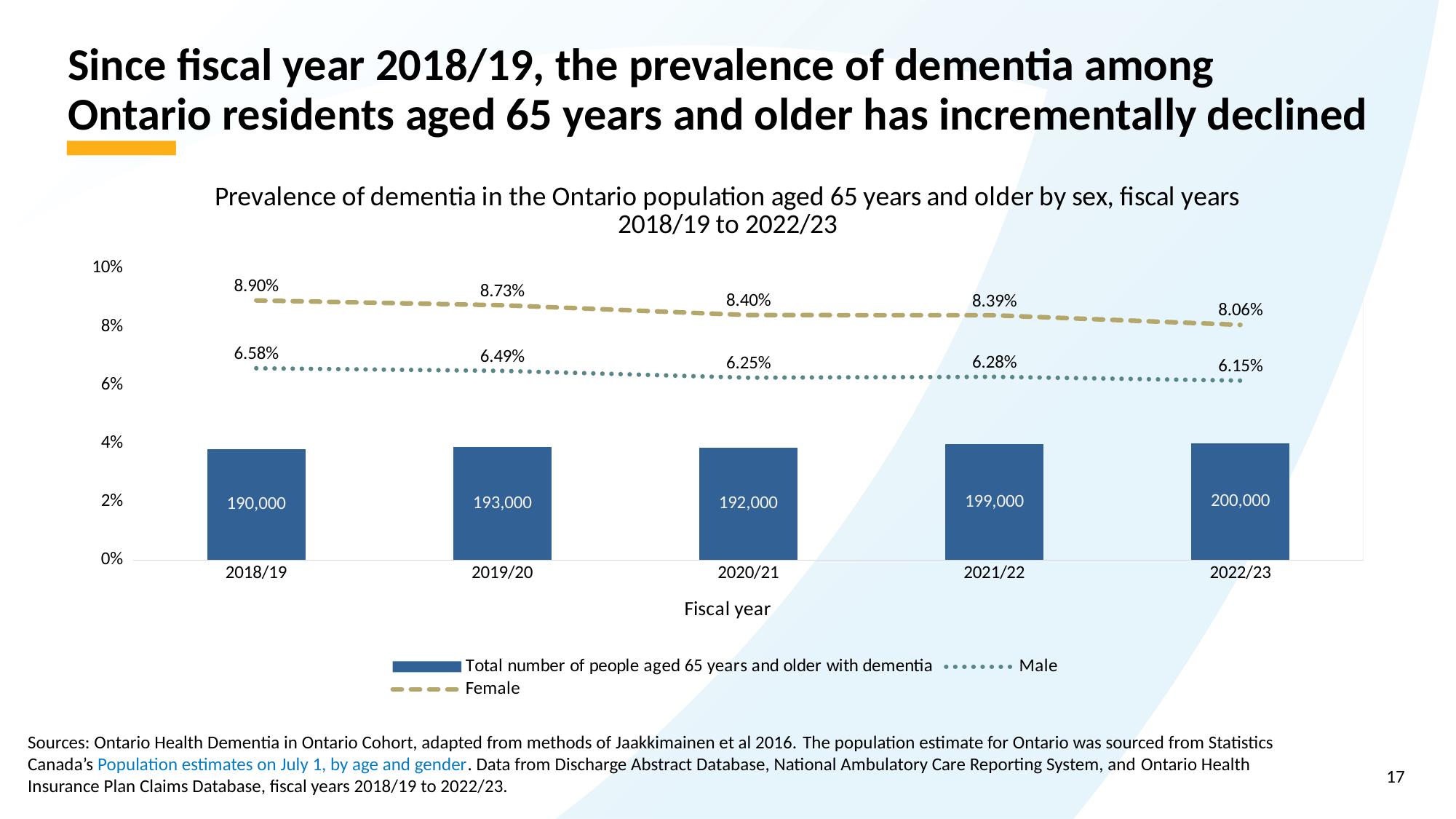
What is the difference between the Female and Male prevalence in fiscal year 2020/21? 2.15% In which fiscal year is the Female prevalence of dementia lowest? 2022/23 What is the Male prevalence of dementia in fiscal year 2022/23? 6.15% What is the total number of people aged 65 years and older with dementia in fiscal year 2021/22? 199,000 Which is larger in fiscal year 2019/20, the Female prevalence or the Male prevalence? Female In which fiscal year is the total number of people aged 65 years and older with dementia highest? 2022/23 What is the Female prevalence of dementia in fiscal year 2018/19? 8.90% What is the title of the chart? Prevalence of dementia in the Ontario population aged 65 years and older by sex, fiscal years 2018/19 to 2022/23 Does the Male prevalence of dementia generally rise or fall from 2018/19 to 2022/23? fall How many fiscal years are shown on the x axis? 5 How many series does the legend list? 3 By how much did the Female prevalence decline from 2018/19 to 2022/23? 0.84%